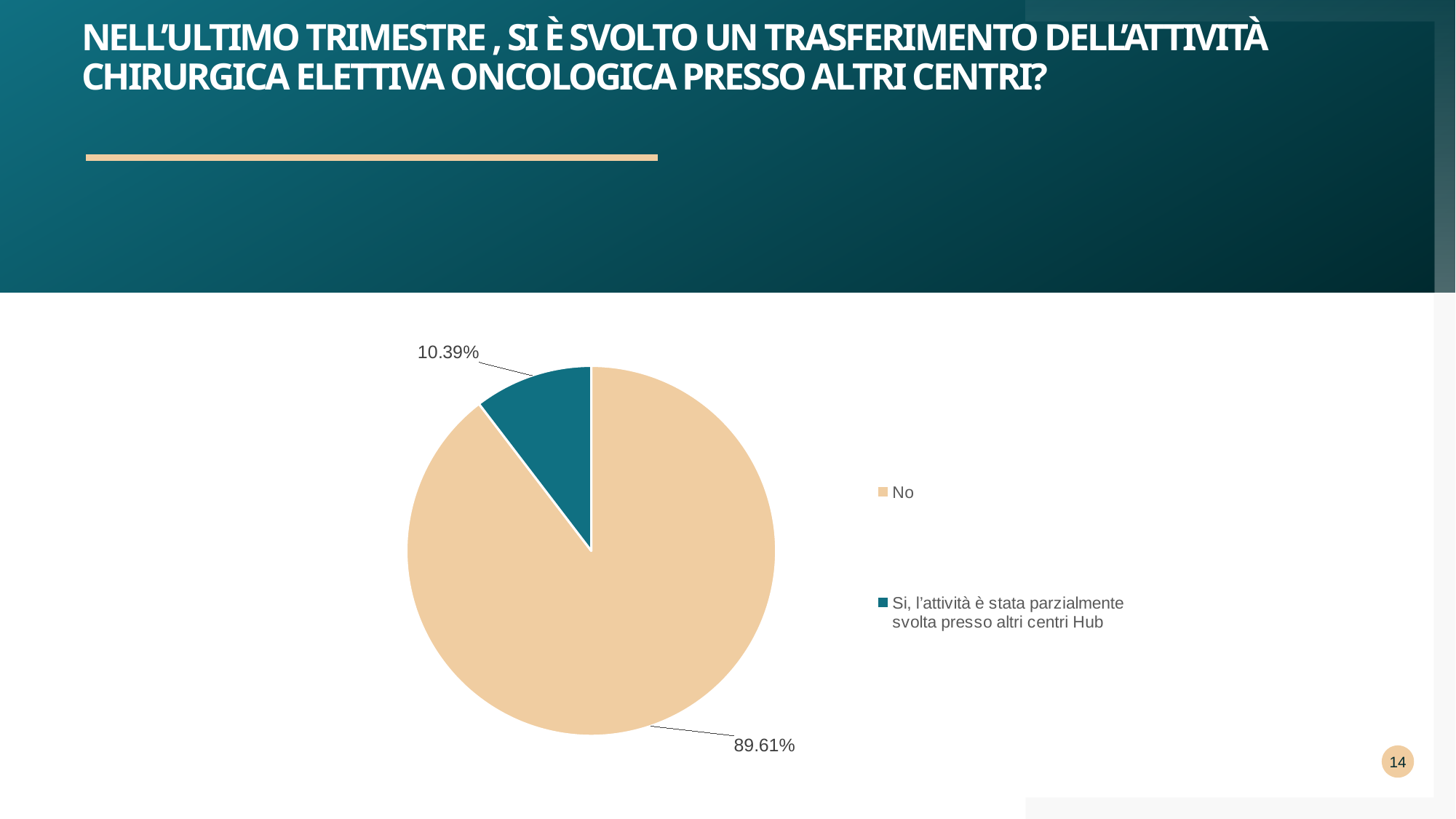
How many entries does the legend list? 2 What colour is the "Si, l'attività è stata parzialmente svolta presso altri centri Hub" slice? teal What share of the pie does the "No" slice represent? 89.61% Which slice of the pie is the smallest? Si, l'attività è stata parzialmente svolta presso altri centri Hub Which is larger: the "No" slice or the "Si, l'attività è stata parzialmente svolta presso altri centri Hub" slice? No What is the difference in percentage points between the "No" slice and the "Si" slice? 79.22 How many slices does the pie chart have? 2 What colour is the "No" slice of the pie? beige Which slice of the pie is the largest? No What kind of chart is shown on the slide? pie chart What share of the pie does the "Si, l'attività è stata parzialmente svolta presso altri centri Hub" slice represent? 10.39%